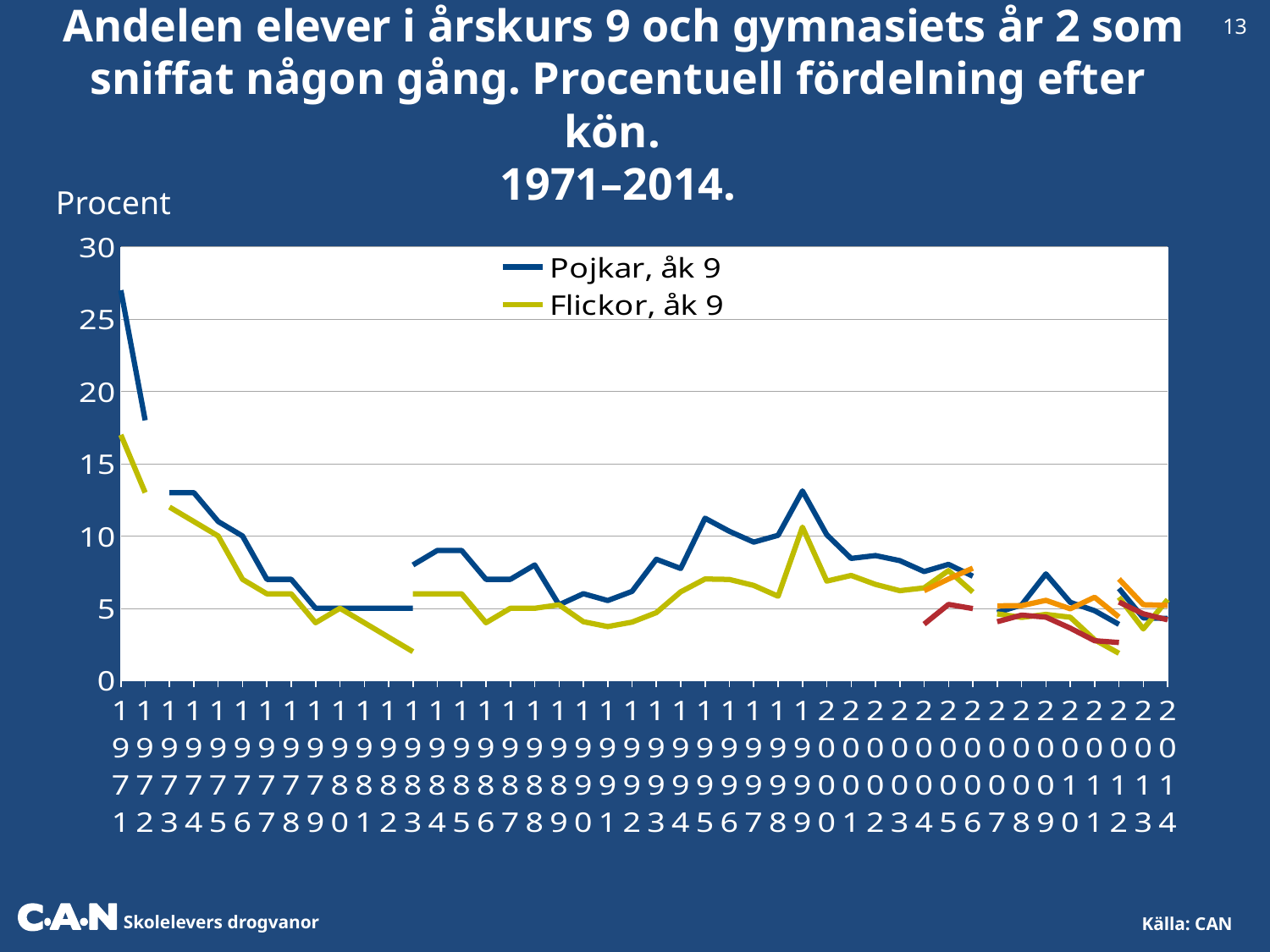
Which two series are named in the legend? Pojkar, åk 9 and Flickor, åk 9 Is the value for Pojkar, åk 9 in 1980 greater or less than 10? less Is the value for Pojkar, åk 9 in 1971 greater or less than 25? greater What label is shown on the vertical axis of the chart? Procent How many series does the legend list? 2 Is the value for Flickor, åk 9 in 1971 greater or less than 15? greater In which year does the Pojkar, åk 9 series reach its highest value? 1971 In 1971, which series has the larger value, Pojkar, åk 9 or Flickor, åk 9? Pojkar, åk 9 What kind of chart is shown on the slide? line chart Does the Pojkar, åk 9 series rise or fall between 1971 and 1980? fall